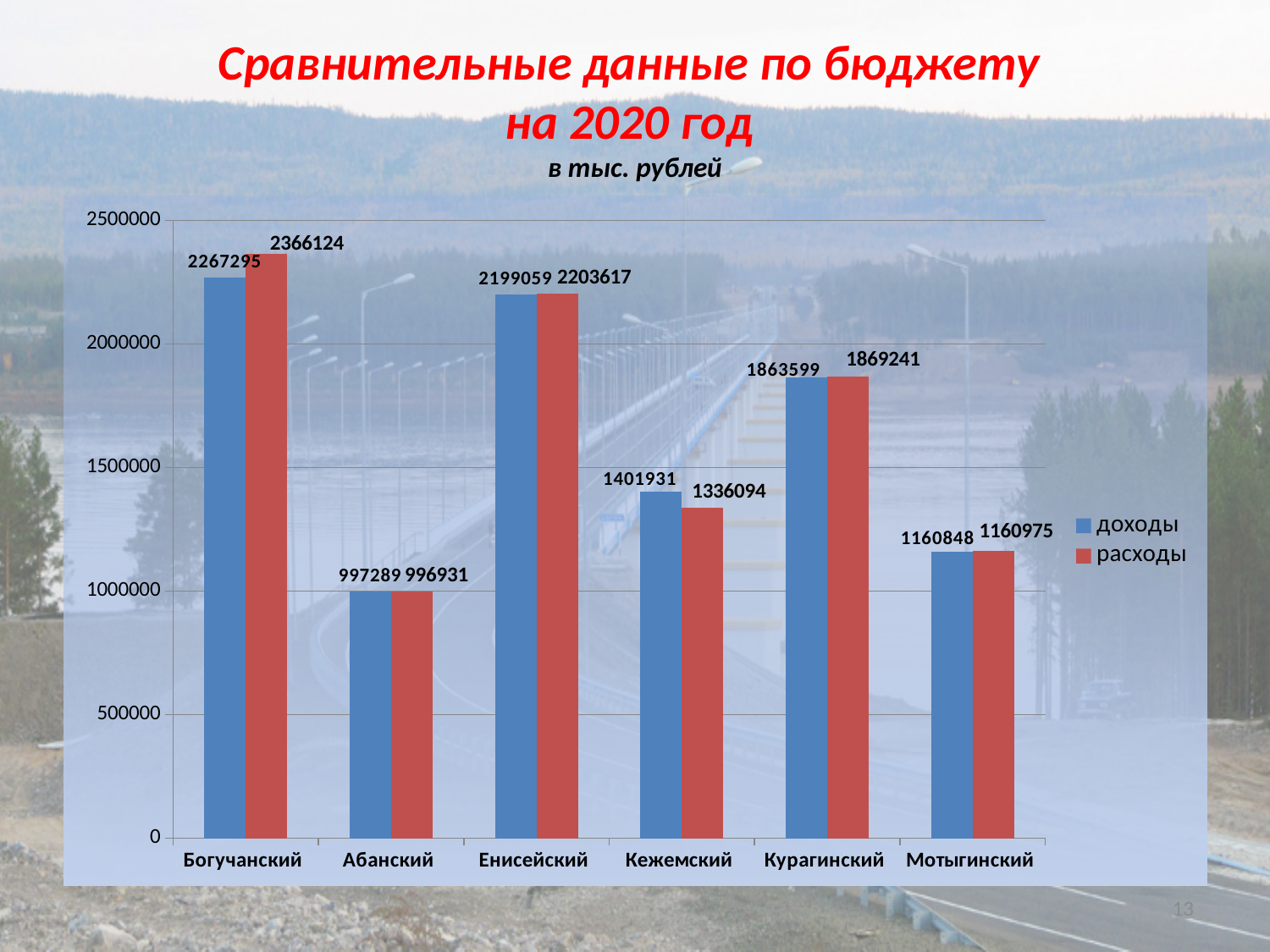
What is the value of доходы for Богучанский? 2267295 What is the value of расходы for Мотыгинский? 1160975 What kind of chart is shown on the slide? bar chart What is the value of расходы for Кежемский? 1336094 What is the difference between расходы and доходы for Богучанский? 98829 What is the difference between доходы and расходы for Кежемский? 65837 What is the value of доходы for Курагинский? 1863599 Which category has the highest доходы? Богучанский Which category has the lowest расходы? Абанский For Кежемский, which is larger: доходы or расходы? доходы How many categories are shown on the x axis? 6 How many series does the legend list? 2